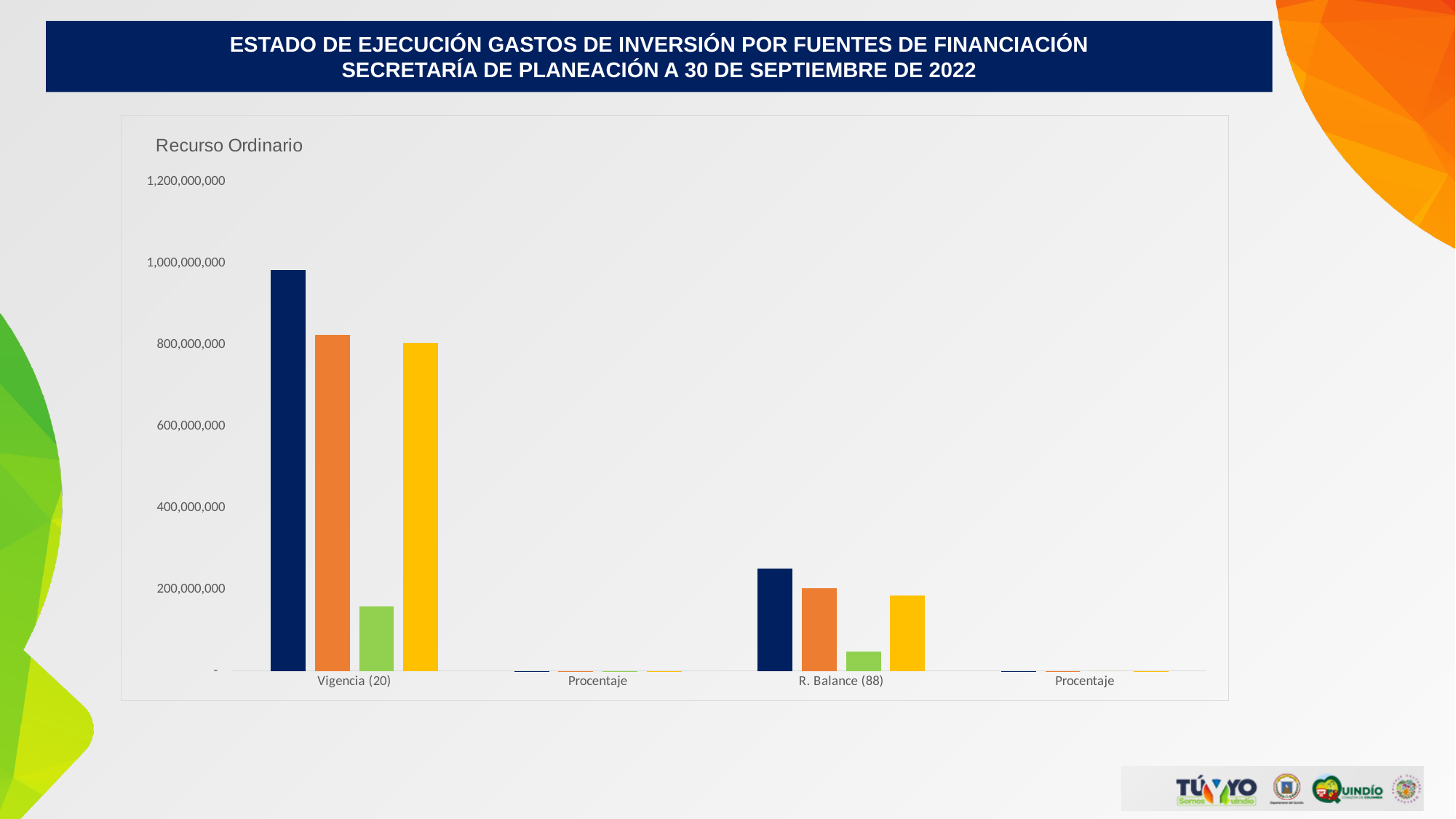
Is the value of the green bar for R. Balance (88) greater or less than 200,000,000? less Is the value of the dark blue bar for Vigencia (20) greater or less than 1,000,000,000? less How many categories are shown on the x axis of the chart? 4 Which is larger: the orange bar for Vigencia (20) or the green bar for Vigencia (20)? the orange bar How many bars are plotted for the Vigencia (20) category? 4 Is the value of the green bar for Vigencia (20) greater or less than 200,000,000? less What kind of chart is shown on the slide? bar chart Which category has the tallest bar in the chart? Vigencia (20) Which is larger: the dark blue bar for Vigencia (20) or the dark blue bar for R. Balance (88)? Vigencia (20) What is the title of the chart? Recurso Ordinario